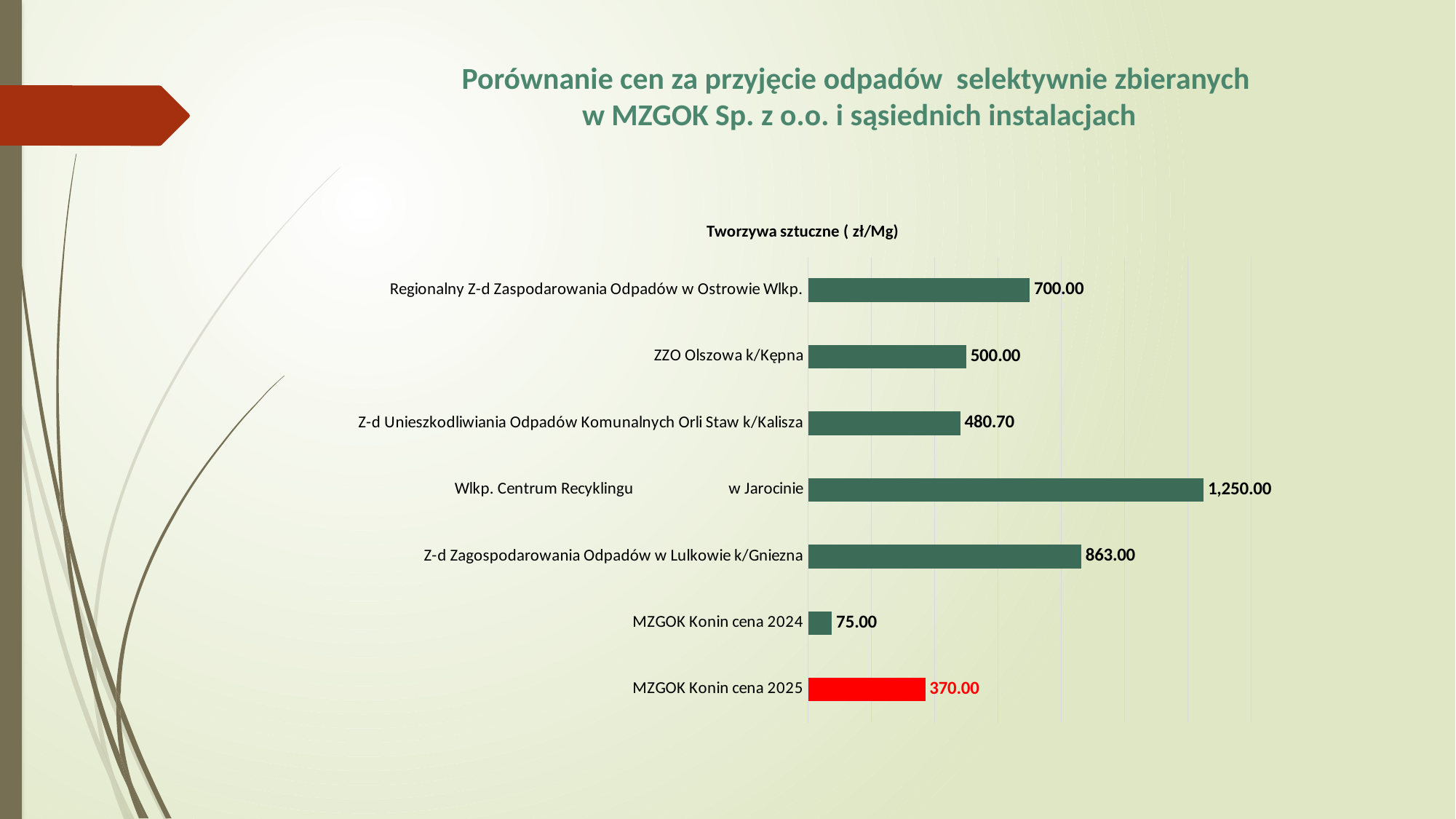
Which category has the highest value? Wlkp. Centrum Recyklingu w Jarocinie What is the title of the chart? Tworzywa sztuczne ( zł/Mg) How many categories are shown in the chart? 7 What is the difference between Z-d Zagospodarowania Odpadów w Lulkowie k/Gniezna and Regionalny Z-d Zaspodarowania Odpadów w Ostrowie Wlkp.? 163.00 Which is larger, the value for ZZO Olszowa k/Kępna or the value for MZGOK Konin cena 2025? ZZO Olszowa k/Kępna What is the value for ZZO Olszowa k/Kępna? 500.00 What is the difference between MZGOK Konin cena 2025 and MZGOK Konin cena 2024? 295.00 What is the value for Wlkp. Centrum Recyklingu w Jarocinie? 1,250.00 What is the value for MZGOK Konin cena 2025? 370.00 What kind of chart is shown on the slide? Bar chart What is the value for Z-d Unieszkodliwiania Odpadów Komunalnych Orli Staw k/Kalisza? 480.70 Which category has the lowest value? MZGOK Konin cena 2024